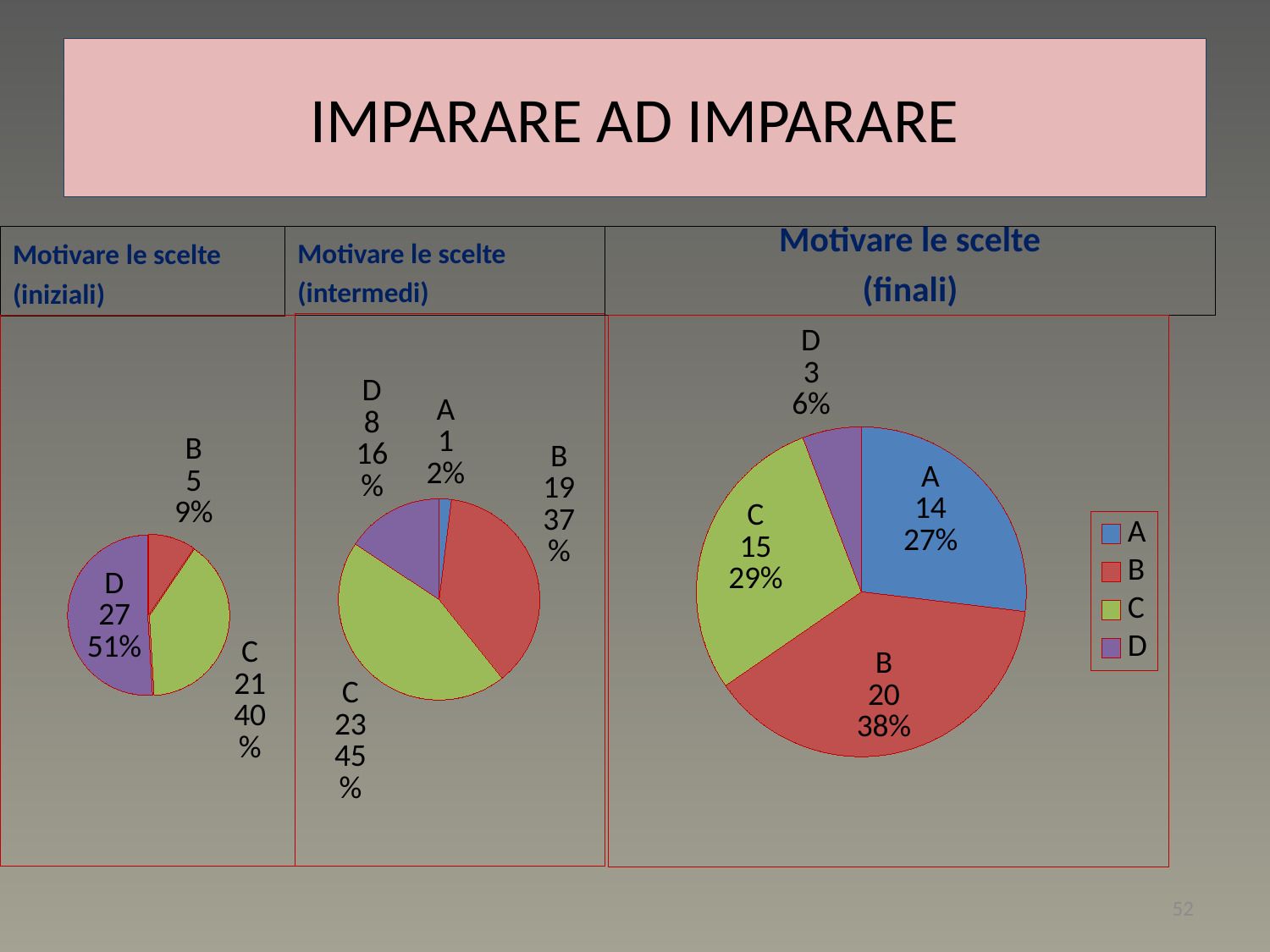
In the 'Motivare le scelte (finali)' chart, what is the difference between the values for B and D? 17 In the 'Motivare le scelte (finali)' chart, what is the value for category B? 20 In the 'Motivare le scelte (finali)' chart, what percentage share does category A have? 27% How many entries does the legend of the 'Motivare le scelte (finali)' chart list? 4 In the 'Motivare le scelte (iniziali)' chart, which is larger, the value for C or the value for B? C In the 'Motivare le scelte (finali)' chart, what colour is the slice for category C? Green What kind of chart is used in the 'Motivare le scelte (finali)' panel? Pie chart In the 'Motivare le scelte (iniziali)' chart, what is the value for category D? 27 In the 'Motivare le scelte (intermedi)' chart, which category has the smallest slice? A In the 'Motivare le scelte (intermedi)' chart, what percentage share does category D have? 16% In the 'Motivare le scelte (iniziali)' chart, which category has the largest slice? D In the 'Motivare le scelte (intermedi)' chart, what is the value for category C? 23